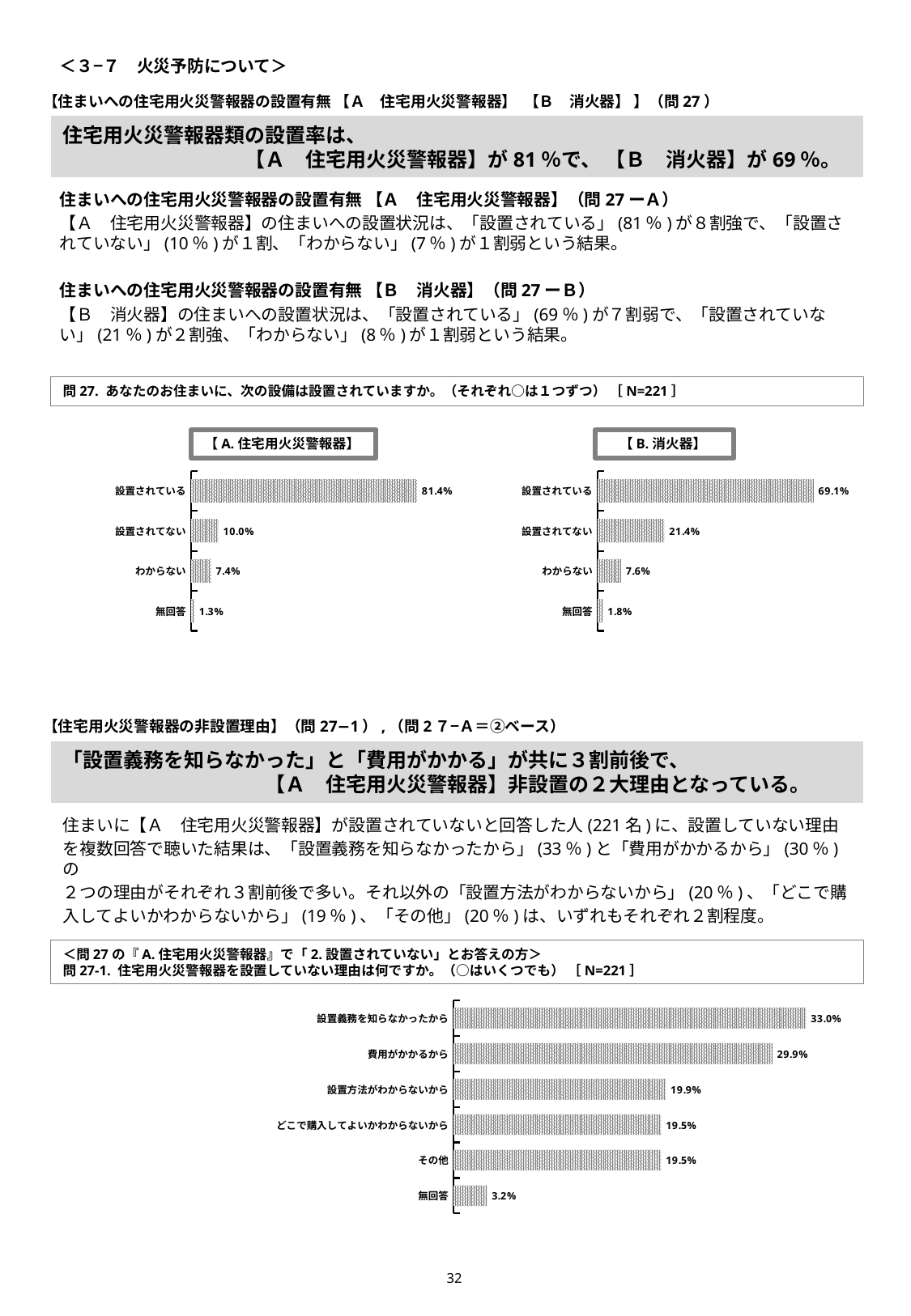
What kind of chart is the 【B. 消火器】 chart? Bar chart In the 問 27-1 chart at the bottom of the slide, what is the value for 費用がかかるから? 29.9% In the 【B. 消火器】 chart, what is the value for 設置されてない? 21.4% How many categories does the 【A. 住宅用火災警報器】 chart show? 4 In the 問 27-1 chart at the bottom of the slide, which category has the highest value? 設置義務を知らなかったから In the 【B. 消火器】 chart, what is the difference between 設置されている and 設置されてない? 47.7% In the 問 27-1 chart at the bottom of the slide, what is the difference between 設置義務を知らなかったから and 設置方法がわからないから? 13.1% How many categories does the 問 27-1 chart at the bottom of the slide show? 6 In the 【A. 住宅用火災警報器】 chart, what is the value for 設置されてない? 10.0% Which is larger: 設置されている in the 【A. 住宅用火災警報器】 chart or 設置されている in the 【B. 消火器】 chart? 【A. 住宅用火災警報器】 In the 【B. 消火器】 chart, which category has the lowest value? 無回答 In the 【A. 住宅用火災警報器】 chart, what is the value for 設置されている? 81.4%